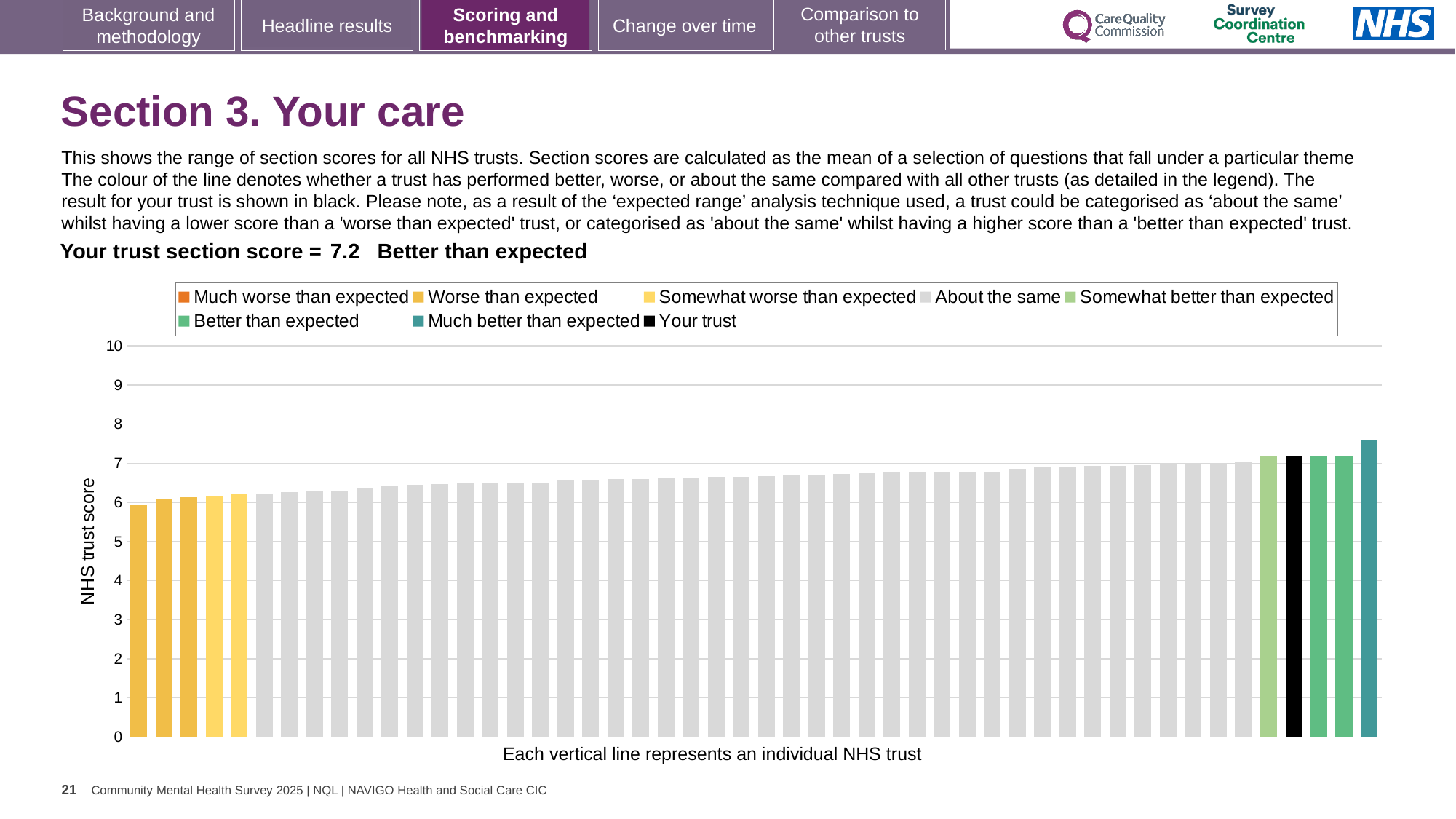
What kind of chart is shown on the slide? Bar chart How many bars are coloured teal, representing 'Much better than expected'? 1 Is the value of the tallest (rightmost) bar greater or less than 7? greater How is your trust's section score categorised compared with other trusts? Better than expected Is the value of the tallest (rightmost) bar greater or less than 8? less What colour is used for the bar representing your trust? Black What is the highest value shown on the vertical axis? 10 What is your trust's section score for Section 3. Your care? 7.2 How many entries does the chart legend list? 8 What is the label on the vertical axis of the chart? NHS trust score Do the bar values rise or fall from left to right along the x axis? Rise Which is higher: the black bar for your trust or the teal bar at the far right? The teal bar at the far right